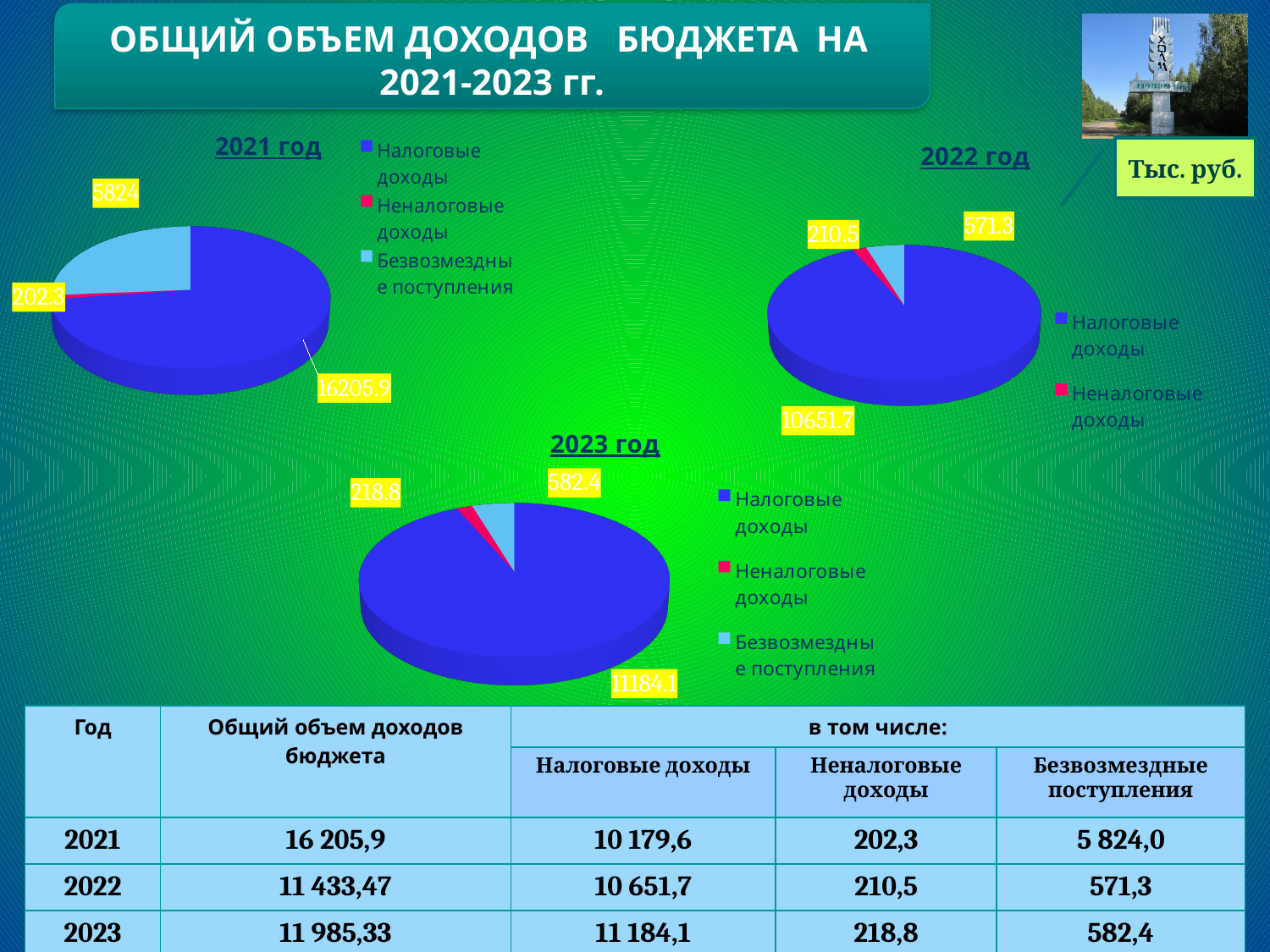
In the "2021 год" chart, what value is labelled for Безвозмездные поступления? 5824 In the "2023 год" chart, what value is labelled for Налоговые доходы? 11184.1 In the "2022 год" chart, which category has the smallest slice? Неналоговые доходы In the "2021 год" chart, what value is labelled for Неналоговые доходы? 202.3 In the "2022 год" chart, what value is labelled for Неналоговые доходы? 210.5 In the "2023 год" chart, which category has the largest slice? Налоговые доходы In the "2023 год" chart, which is larger: Неналоговые доходы or Безвозмездные поступления? Безвозмездные поступления In the "2023 год" chart, what value is labelled for Безвозмездные поступления? 582.4 In the "2022 год" chart, what is the difference between the labelled values for Безвозмездные поступления (571.3) and Неналоговые доходы (210.5)? 360.8 In the "2022 год" chart, what value is labelled for Налоговые доходы? 10651.7 How many entries does the legend of the "2023 год" chart list? 3 What kind of chart is the "2021 год" chart? Pie chart